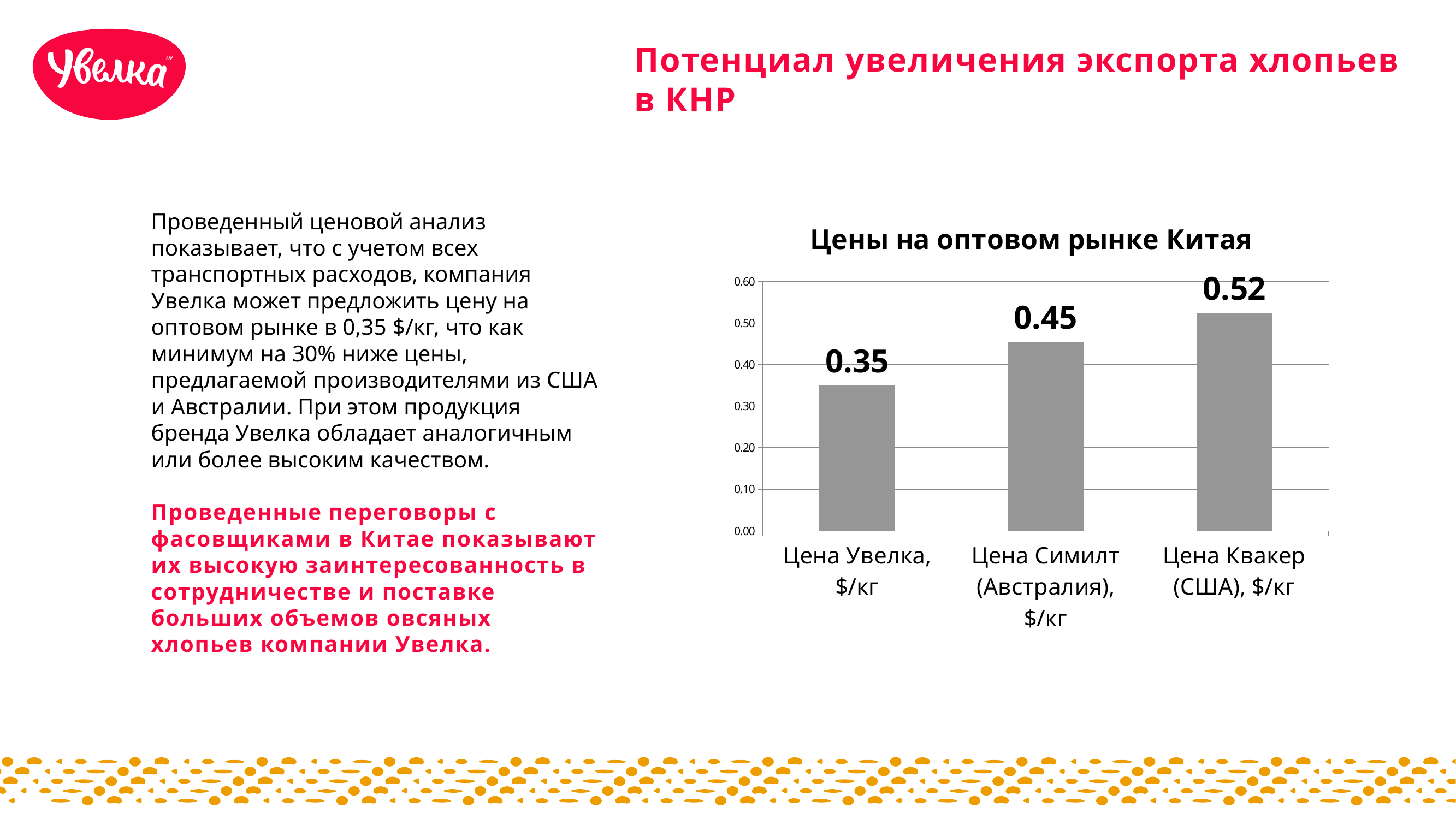
Which category has the lowest value? Цена Увелка, $/кг What is the title of the chart? Цены на оптовом рынке Китая What is the value for Цена Квакер (США), $/кг? 0.52 What kind of chart is shown on the slide? bar chart How many categories are shown in the chart? 3 Which is larger: the value for Цена Симилт (Австралия), $/кг or the value for Цена Квакер (США), $/кг? Цена Квакер (США), $/кг Is the value for Цена Квакер (США), $/кг greater or less than 0.50? greater What is the difference between the value for Цена Квакер (США), $/кг and the value for Цена Увелка, $/кг? 0.17 What is the difference between the value for Цена Симилт (Австралия), $/кг and the value for Цена Увелка, $/кг? 0.10 What is the value for Цена Симилт (Австралия), $/кг? 0.45 What is the value for Цена Увелка, $/кг? 0.35 Which category has the highest value? Цена Квакер (США), $/кг